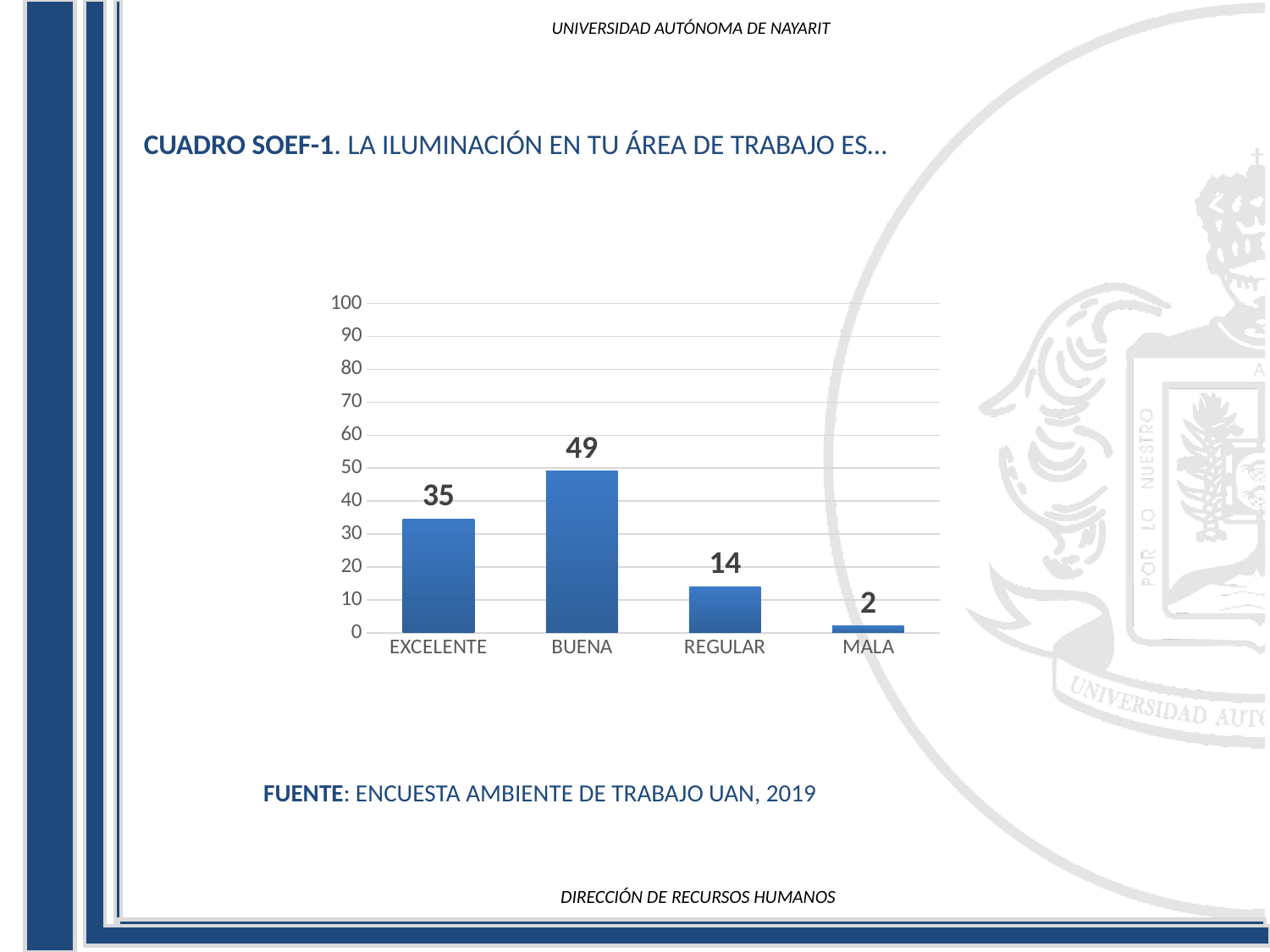
Which category has the lowest value? MALA How many categories are shown on the x axis? 4 Which category has the highest value? BUENA What kind of chart is shown on the slide? bar chart What is the value for BUENA? 49 What is the difference between the values for BUENA and EXCELENTE? 14 Is the value for BUENA greater or less than 40? greater What is the value for REGULAR? 14 What is the value for EXCELENTE? 35 What is the difference between the values for REGULAR and MALA? 12 What is the value for MALA? 2 Which is larger, the value for EXCELENTE or the value for REGULAR? EXCELENTE